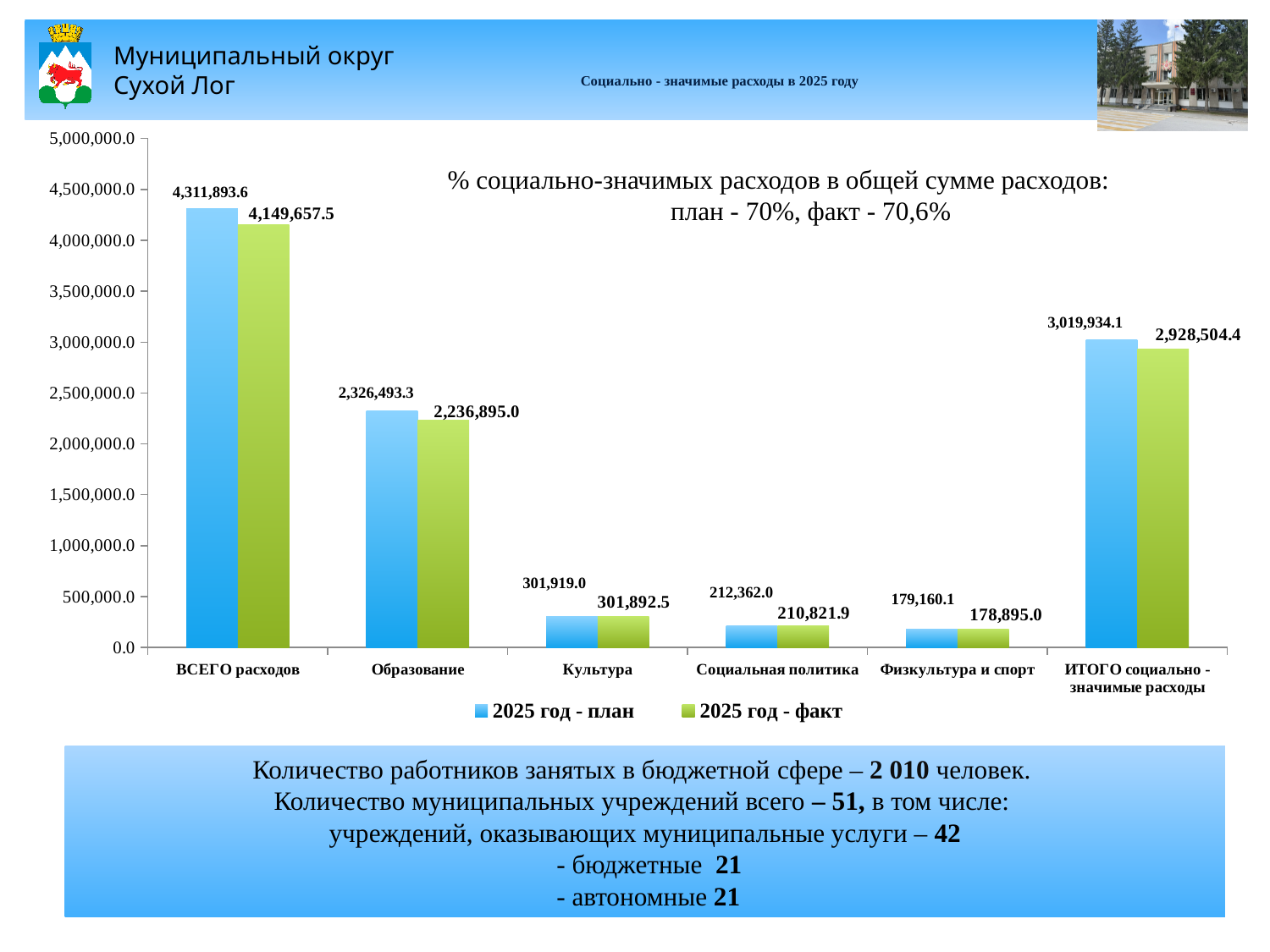
What is the value of the 2025 год - план bar for Образование? 2,326,493.3 Is the 2025 год - факт value for Образование greater or less than 2,000,000.0? greater Which is larger: the 2025 год - план value for Культура or for Социальная политика? Культура What is the 2025 год - факт value for Социальная политика? 210,821.9 Which category has the highest 2025 год - план value? ВСЕГО расходов Which category has the lowest 2025 год - факт value? Физкультура и спорт How many series does the chart legend list? 2 What type of chart is shown on the slide? bar chart How many categories are shown on the x axis of the chart? 6 What is the value of the 2025 год - факт bar for ИТОГО социально - значимые расходы? 2,928,504.4 What is the difference between the 2025 год - план and 2025 год - факт values for Образование? 89,598.3 What is the difference between the 2025 год - план and 2025 год - факт values for ВСЕГО расходов? 162,236.1